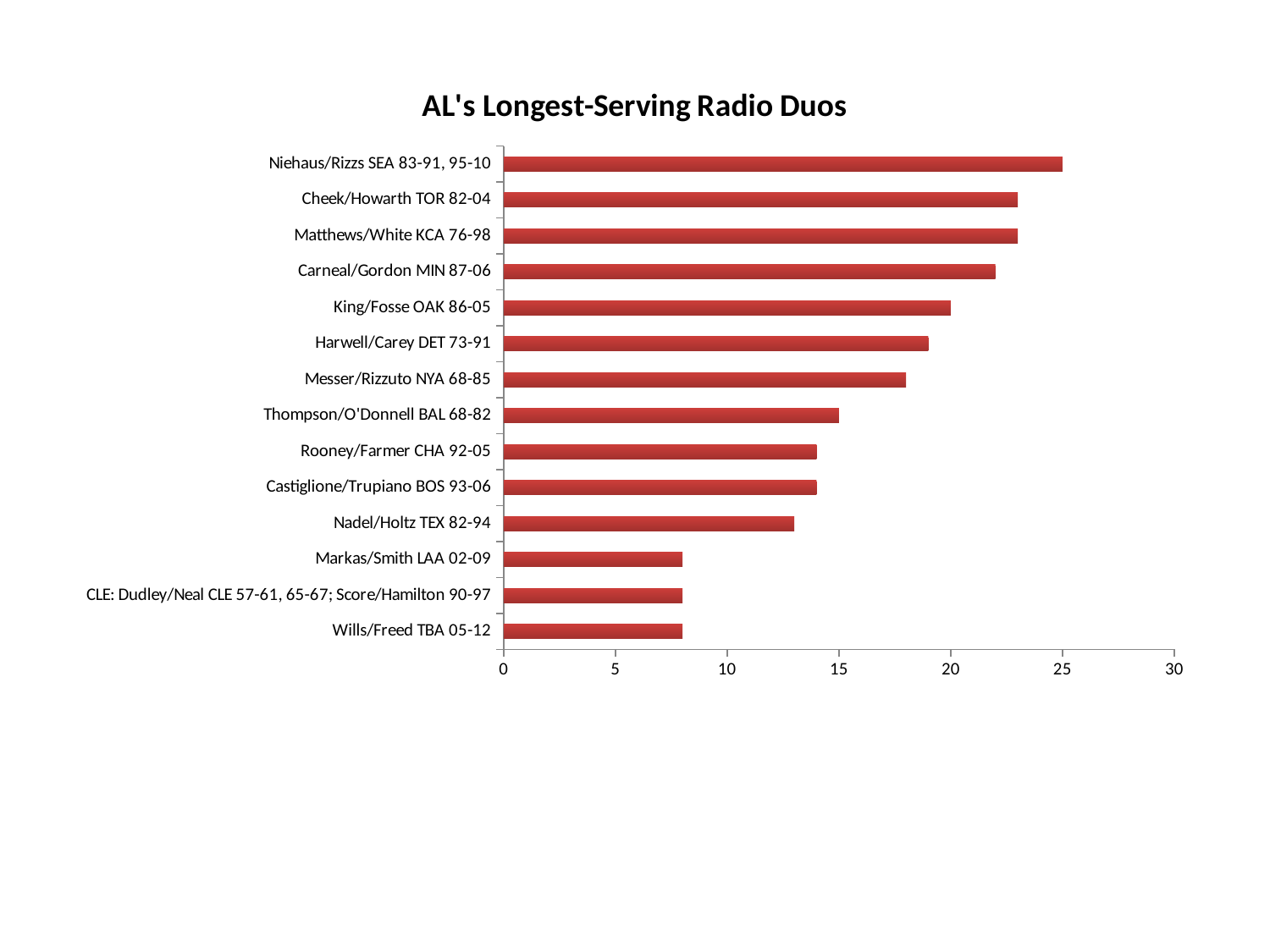
What kind of chart is shown on the slide? bar chart Which radio duo has the longest bar in the chart? Niehaus/Rizzs SEA 83-91, 95-10 Which has the larger value, Carneal/Gordon MIN 87-06 or Harwell/Carey DET 73-91? Carneal/Gordon MIN 87-06 Is the value for Messer/Rizzuto NYA 68-85 greater or less than 20? less How many radio duos are plotted in the chart? 14 What is the value for Thompson/O'Donnell BAL 68-82? 15 What is the difference between the values for Niehaus/Rizzs SEA 83-91, 95-10 and King/Fosse OAK 86-05? 5 What is the value for King/Fosse OAK 86-05? 20 Is the value for Cheek/Howarth TOR 82-04 greater or less than 20? greater Is the value for Markas/Smith LAA 02-09 greater or less than 10? less What is the title of the chart? AL's Longest-Serving Radio Duos What is the value for Niehaus/Rizzs SEA 83-91, 95-10? 25